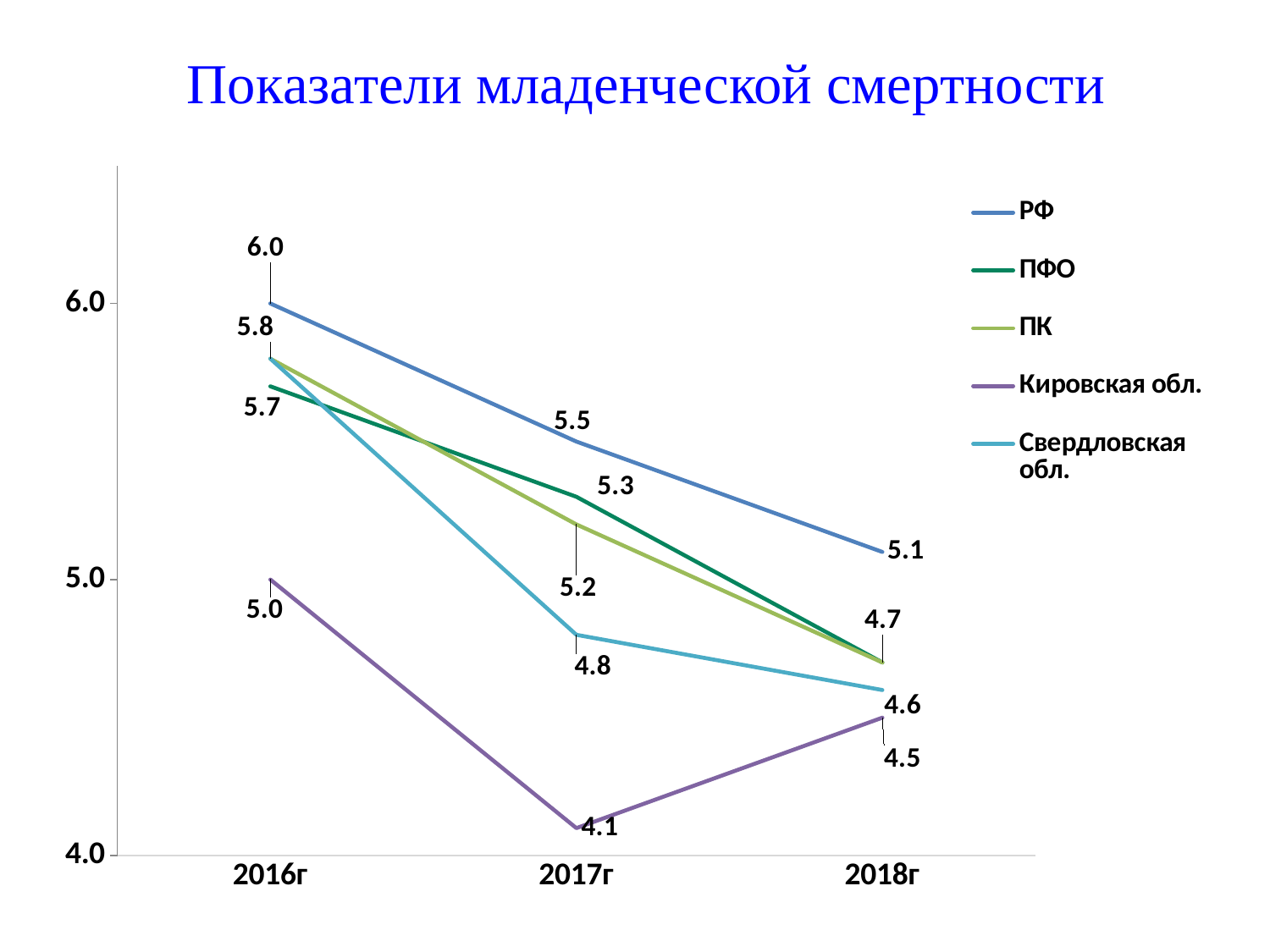
How many years are shown on the x axis? 3 What is the value for Свердловская обл. in 2017г? 4.8 What kind of chart is shown on the slide? Line chart What is the value for Кировская обл. in 2017г? 4.1 What is the value for РФ in 2018г? 5.1 By how much did the value for РФ decrease from 2016г to 2018г? 0.9 What is the value for РФ in 2016г? 6.0 Which series has the lowest value in 2017г? Кировская обл. In 2018г, which is larger: the value for ПФО or for Свердловская обл.? ПФО Which series has the highest value in 2016г? РФ What is the value for ПФО in 2017г? 5.3 How many series does the legend list? 5